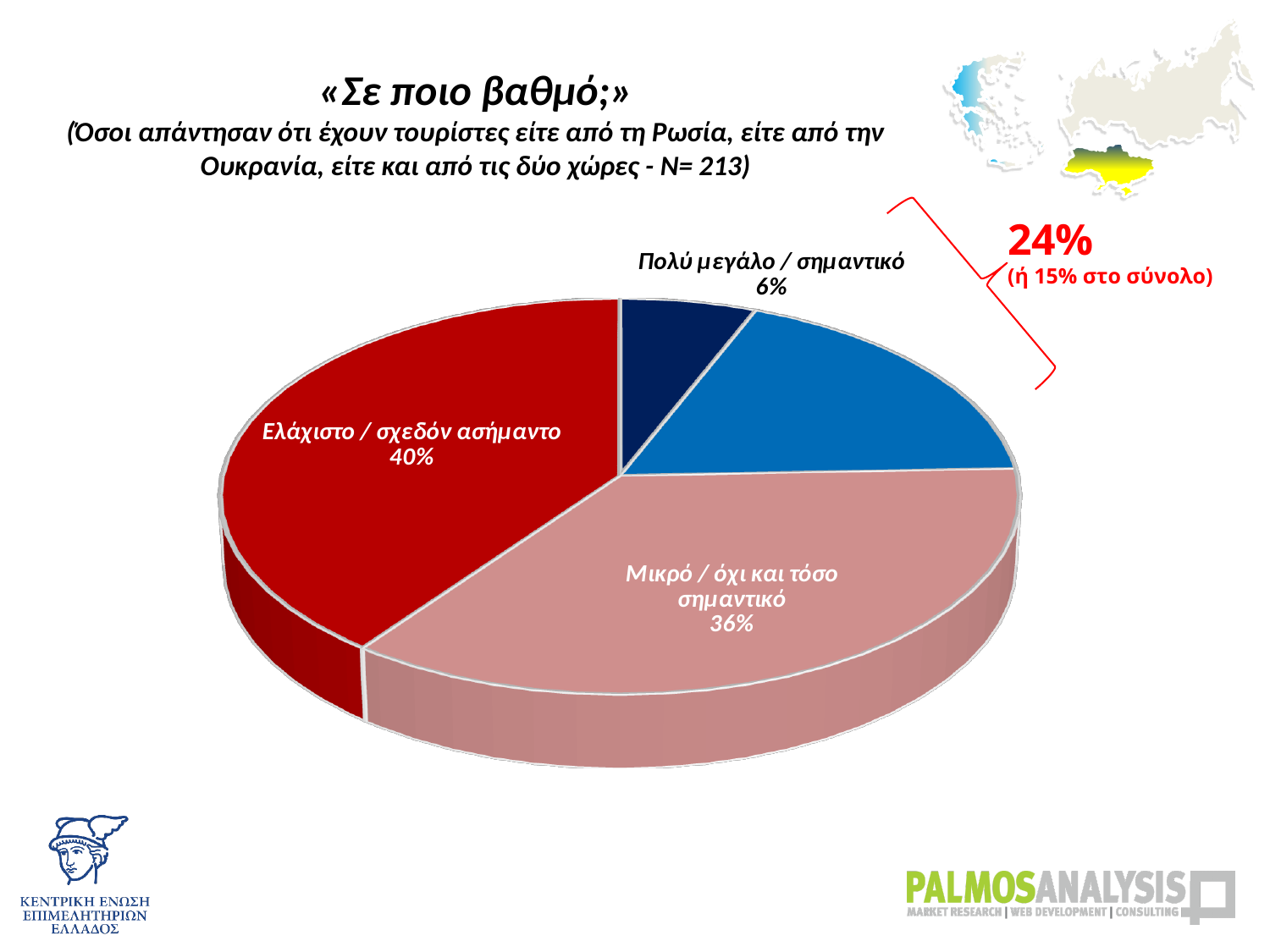
What percentage is shown for the slice "Ελάχιστο / σχεδόν ασήμαντο"? 40% What combined percentage is shown in red next to the bracket grouping the two blue slices? 24% What percentage is shown for the slice "Μικρό / όχι και τόσο σημαντικό"? 36% What kind of chart is shown on the slide? pie chart Which labelled slice of the pie chart is the largest? Ελάχιστο / σχεδόν ασήμαντο What percentage is shown for the slice "Πολύ μεγάλο / σημαντικό"? 6% What is the difference in percentage points between "Ελάχιστο / σχεδόν ασήμαντο" and "Μικρό / όχι και τόσο σημαντικό"? 4 percentage points Which slice of the pie chart is the smallest? Πολύ μεγάλο / σημαντικό How many slices does the pie chart have? 4 What share of the pie does "Μικρό / όχι και τόσο σημαντικό" represent? 36% What is the sample size (N) stated in the chart subtitle? N= 213 Which is larger: the slice "Μικρό / όχι και τόσο σημαντικό" or the slice "Πολύ μεγάλο / σημαντικό"? Μικρό / όχι και τόσο σημαντικό